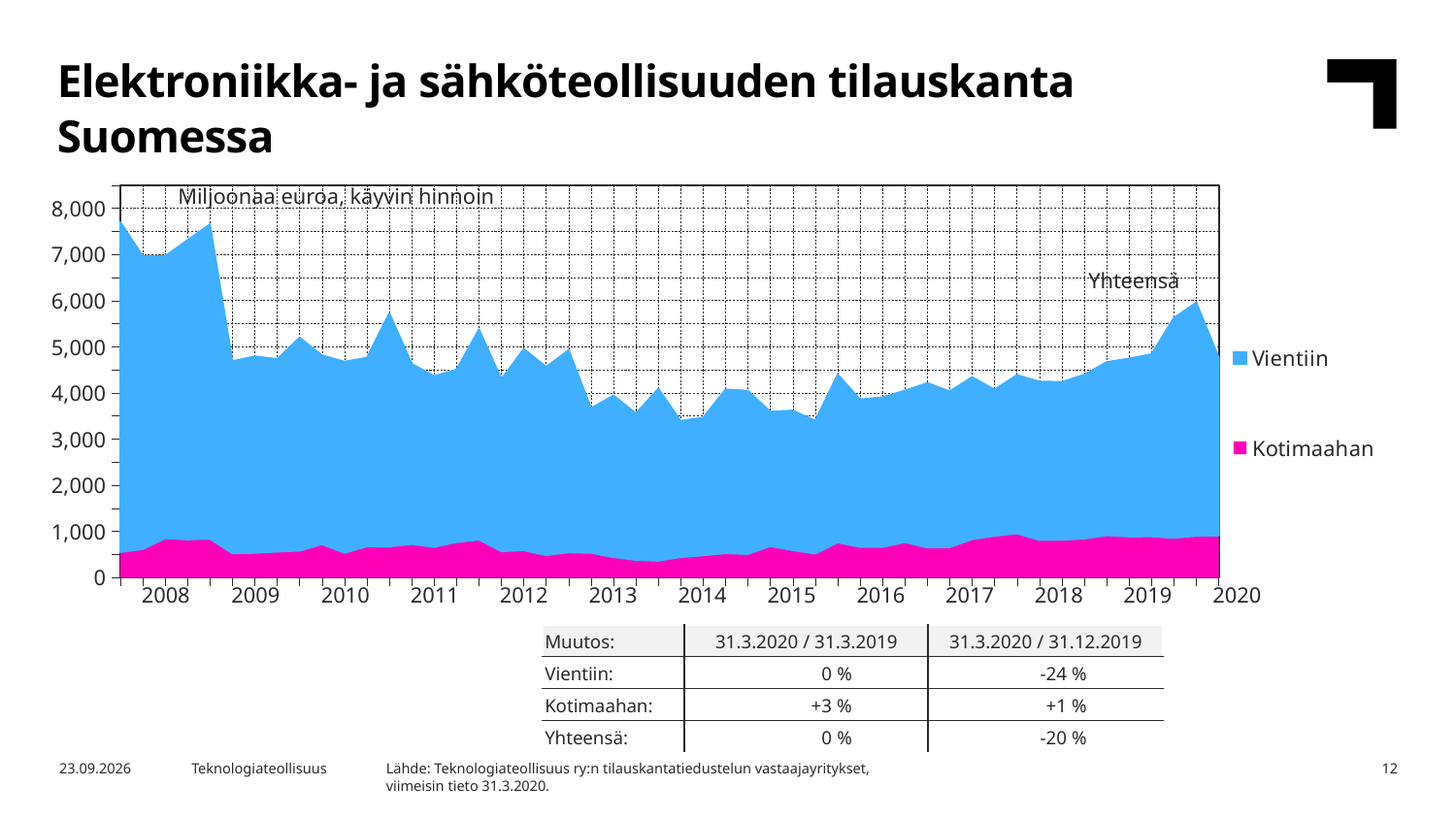
Is the Kotimaahan value in 2018 greater or less than 2,000? less How many series does the chart legend list? 2 What kind of chart is shown on the slide? Stacked area chart Is the total (Yhteensä) value at the start of 2008 greater or less than 7,000? greater Does the total order backlog rise or fall between 2008 and 2009? Fall What is the highest value shown on the y axis? 8,000 What unit is stated at the top of the chart? Miljoonaa euroa, käyvin hinnoin Which series is larger in 2016, Vientiin or Kotimaahan? Vientiin Which two series are listed in the chart legend? Vientiin and Kotimaahan How many year labels are shown on the x axis? 13